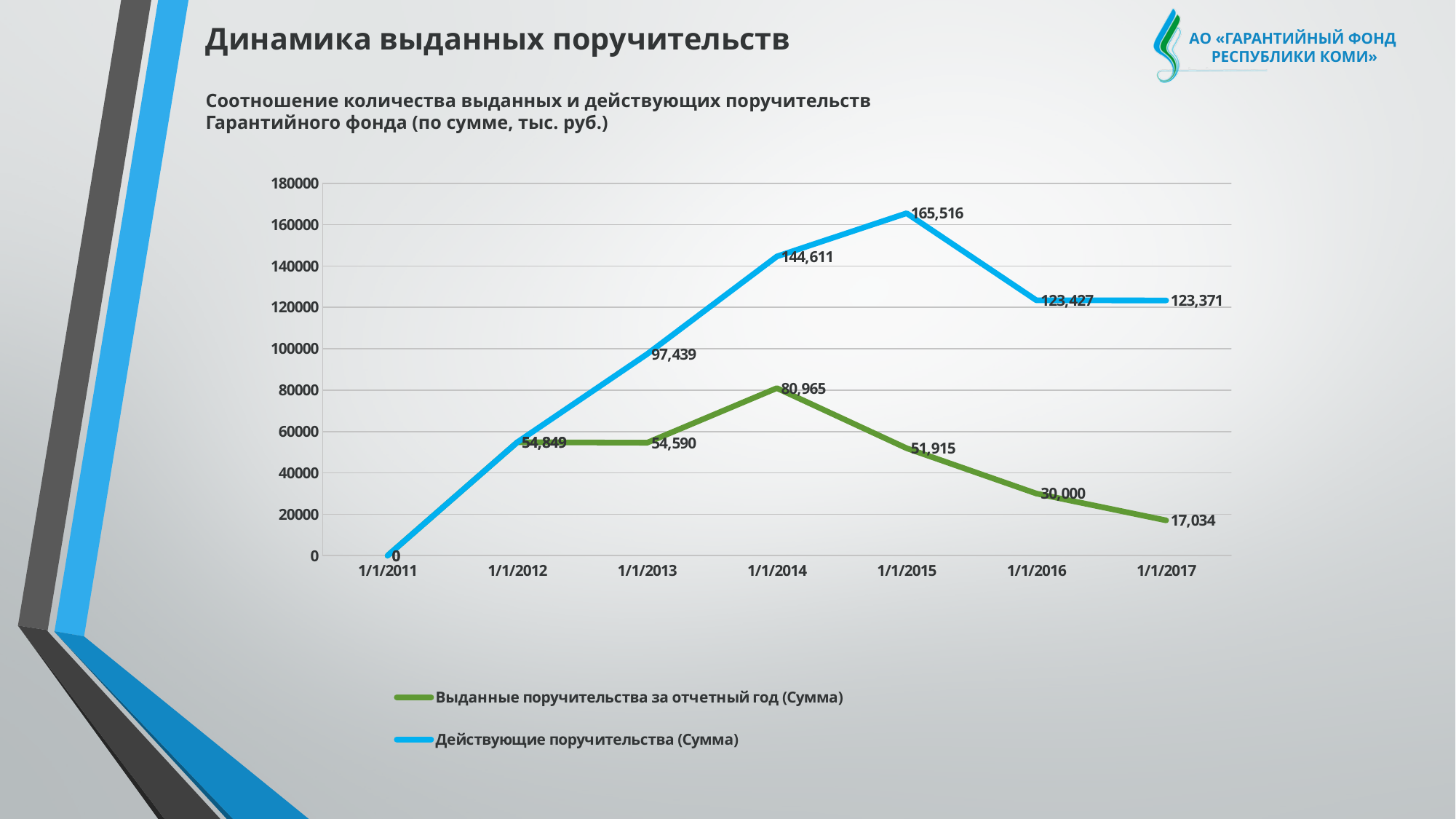
What is the value of Выданные поручительства за отчетный год (Сумма) at 1/1/2014? 80,965 At which date is Выданные поручительства за отчетный год (Сумма) at its lowest value? 1/1/2011 By how much did Выданные поручительства за отчетный год (Сумма) fall from 1/1/2014 to 1/1/2015? 29,050 What is the value of Действующие поручительства (Сумма) at 1/1/2013? 97,439 What kind of chart is shown on the slide? line chart How many series does the legend list? 2 At which date does Действующие поручительства (Сумма) reach its highest value? 1/1/2015 What is the value of Выданные поручительства за отчетный год (Сумма) at 1/1/2017? 17,034 What is the difference between Действующие поручительства (Сумма) at 1/1/2016 and at 1/1/2017? 56 At 1/1/2014, which series has the larger value: Действующие поручительства (Сумма) or Выданные поручительства за отчетный год (Сумма)? Действующие поручительства (Сумма) What is the value of Действующие поручительства (Сумма) at 1/1/2015? 165,516 How many dates are shown on the x axis? 7